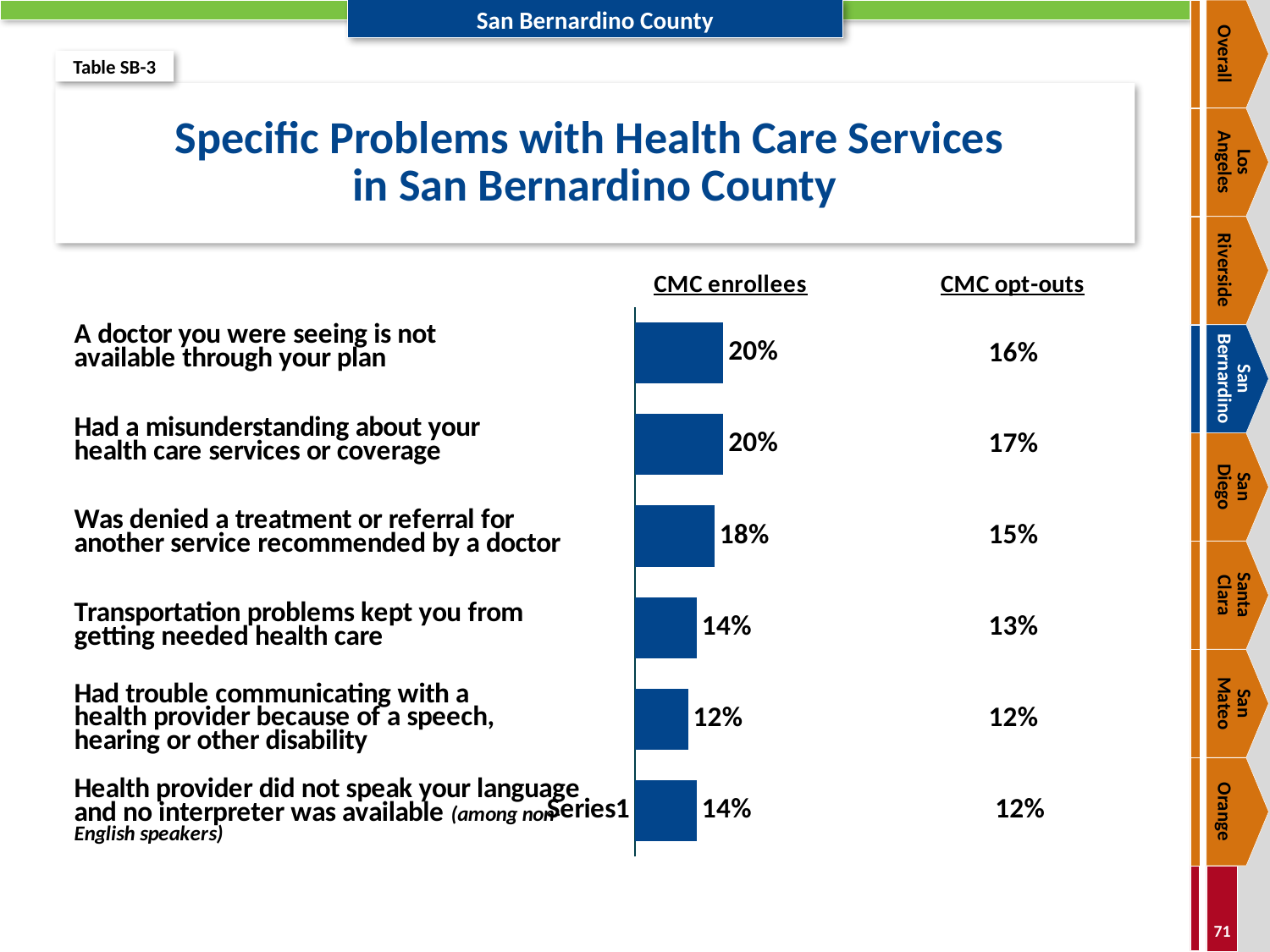
What is the difference between the CMC enrollees and CMC opt-outs values for 'A doctor you were seeing is not available through your plan'? 4 percentage points What is the CMC opt-outs value for 'Had a misunderstanding about your health care services or coverage'? 17% What kind of chart is shown on the slide? Bar chart What is the CMC enrollees value for 'Had trouble communicating with a health provider because of a speech, hearing or other disability'? 12% What is the title of the chart? Specific Problems with Health Care Services in San Bernardino County What is the CMC enrollees value for 'Was denied a treatment or referral for another service recommended by a doctor'? 18% Which category has the lowest CMC enrollees value? Had trouble communicating with a health provider because of a speech, hearing or other disability How many problem categories are shown in the chart? 6 Which has a larger CMC enrollees value: 'Was denied a treatment or referral for another service recommended by a doctor' or 'Transportation problems kept you from getting needed health care'? Was denied a treatment or referral for another service recommended by a doctor What is the CMC enrollees value for 'Transportation problems kept you from getting needed health care'? 14% What is the difference between the CMC enrollees values for 'A doctor you were seeing is not available through your plan' and 'Transportation problems kept you from getting needed health care'? 6 percentage points What is the CMC enrollees value for 'A doctor you were seeing is not available through your plan'? 20%